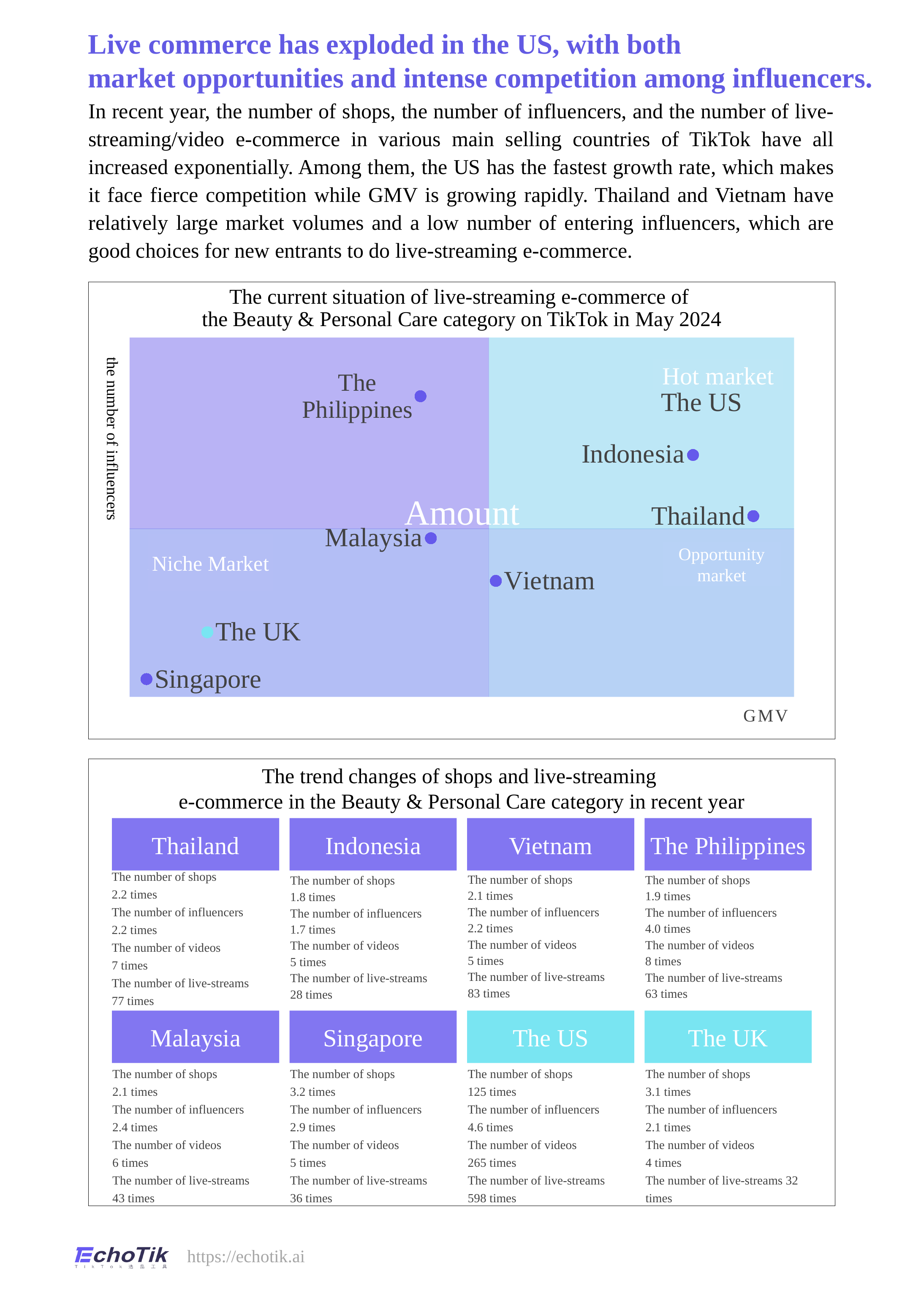
In the top chart, how many countries are labelled? 8 In the top chart, which has the larger GMV, Thailand or Malaysia? Thailand In the top chart, which country has the lowest number of influencers? Singapore In the bottom panel on trend changes, by how many times did the number of videos grow for Thailand? 7 times In the bottom panel on trend changes, what is the difference between Vietnam's and Thailand's growth in the number of live-streams? 6 times In the top chart, which quadrant is Vietnam plotted in? Opportunity market In the bottom panel on trend changes, by how many times did the number of influencers grow for The Philippines? 4.0 times What kind of chart is the top chart titled 'The current situation of live-streaming e-commerce of the Beauty & Personal Care category on TikTok in May 2024'? scatter chart In the bottom panel on trend changes, by how many times did the number of live-streams grow for The US? 598 times In the bottom panel on trend changes, which country has the largest growth in the number of shops? The US In the top chart, what is the label of the horizontal axis? GMV